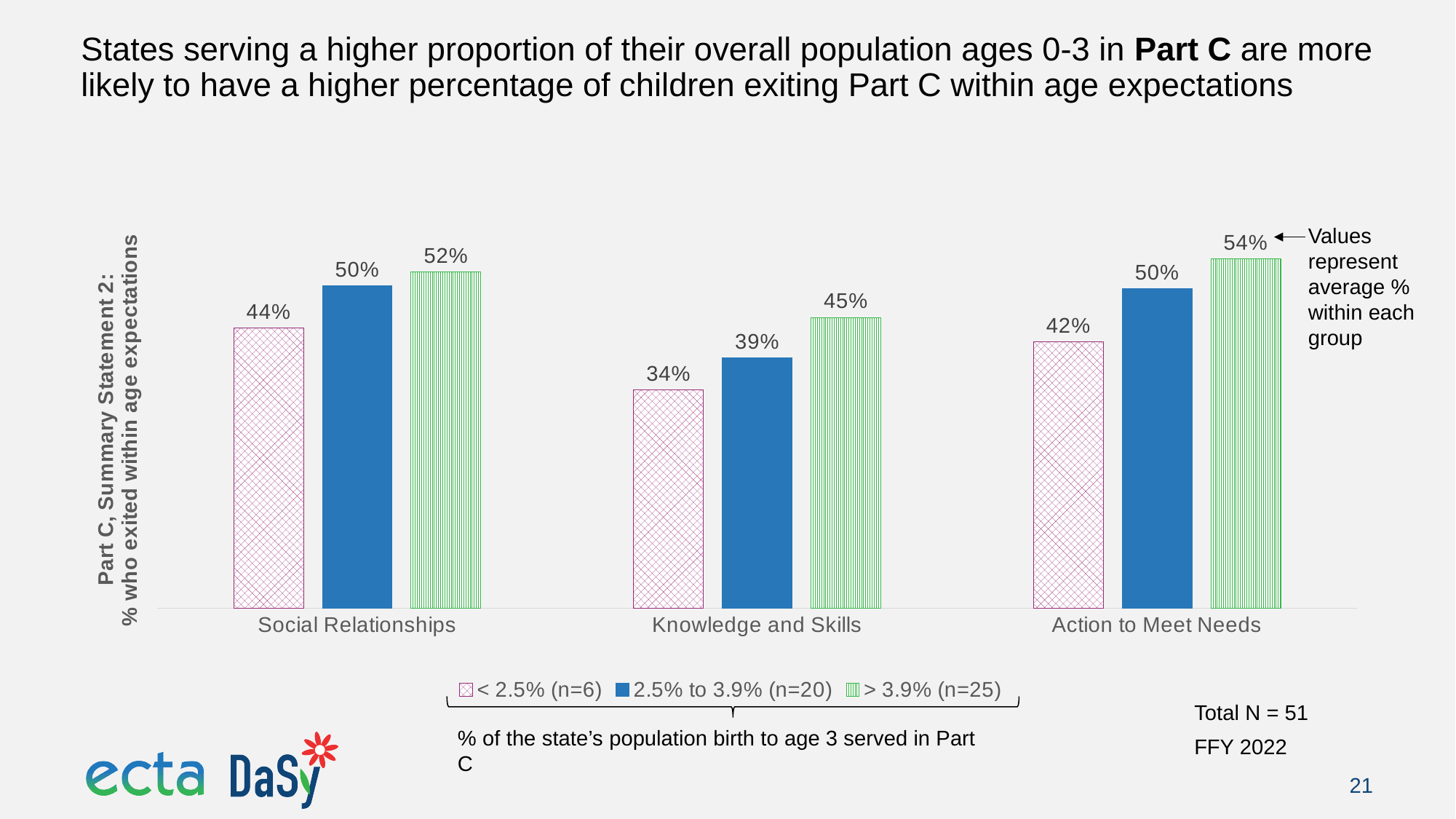
What is the total N stated on the slide? 51 What is the value for the '2.5% to 3.9% (n=20)' group in the Action to Meet Needs category? 50% How many series does the legend list? 3 Which category has the lowest value for the '< 2.5% (n=6)' group? Knowledge and Skills Which is larger in the Social Relationships category: the '< 2.5% (n=6)' value or the '2.5% to 3.9% (n=20)' value? 2.5% to 3.9% (n=20) What is the value for the '> 3.9% (n=25)' group in the Social Relationships category? 52% Within each category, do the values rise or fall as the group moves from '< 2.5%' to '> 3.9%'? Rise What is the value for the '< 2.5% (n=6)' group in the Knowledge and Skills category? 34% What is the difference between the '> 3.9% (n=25)' and '< 2.5% (n=6)' values in the Knowledge and Skills category? 11% Which group has the highest value in the Action to Meet Needs category? > 3.9% (n=25) How many categories are shown on the x axis? 3 What kind of chart is shown on the slide? Bar chart